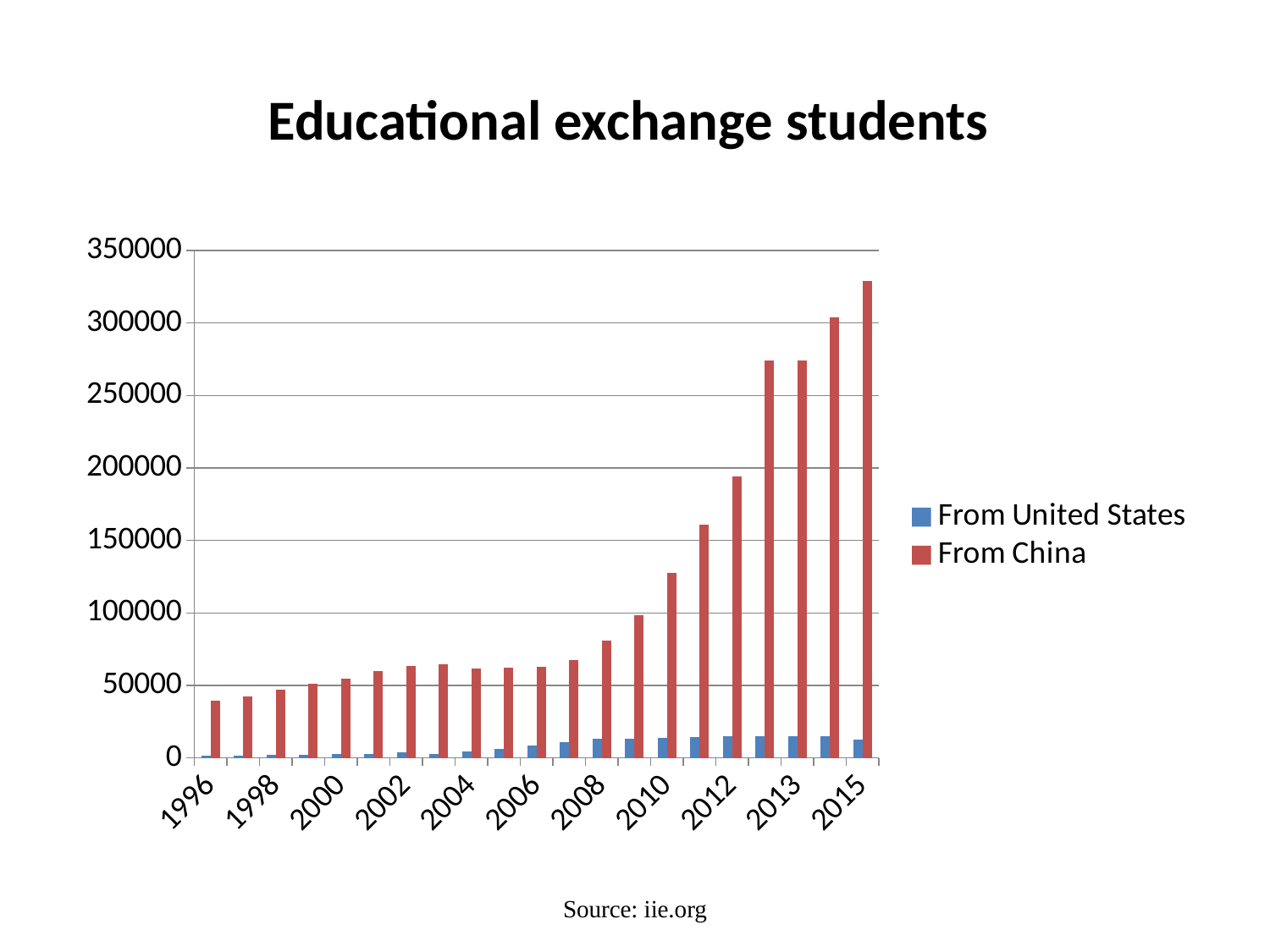
What is the title of the chart? Educational exchange students Is the From China value for 2015 greater or less than 300000? greater In 2015, which series has the larger value, From United States or From China? From China Is the From China value for 1996 greater or less than 50000? less Which year has the lowest value for From China? 1996 Is the From United States value for 2012 greater or less than 50000? less Do the From China values generally rise or fall from 1996 to 2015? rise What kind of chart is shown on the slide? bar chart How many series does the legend list? 2 What are the two series named in the legend? From United States, From China Which year has the highest value for From China? 2015